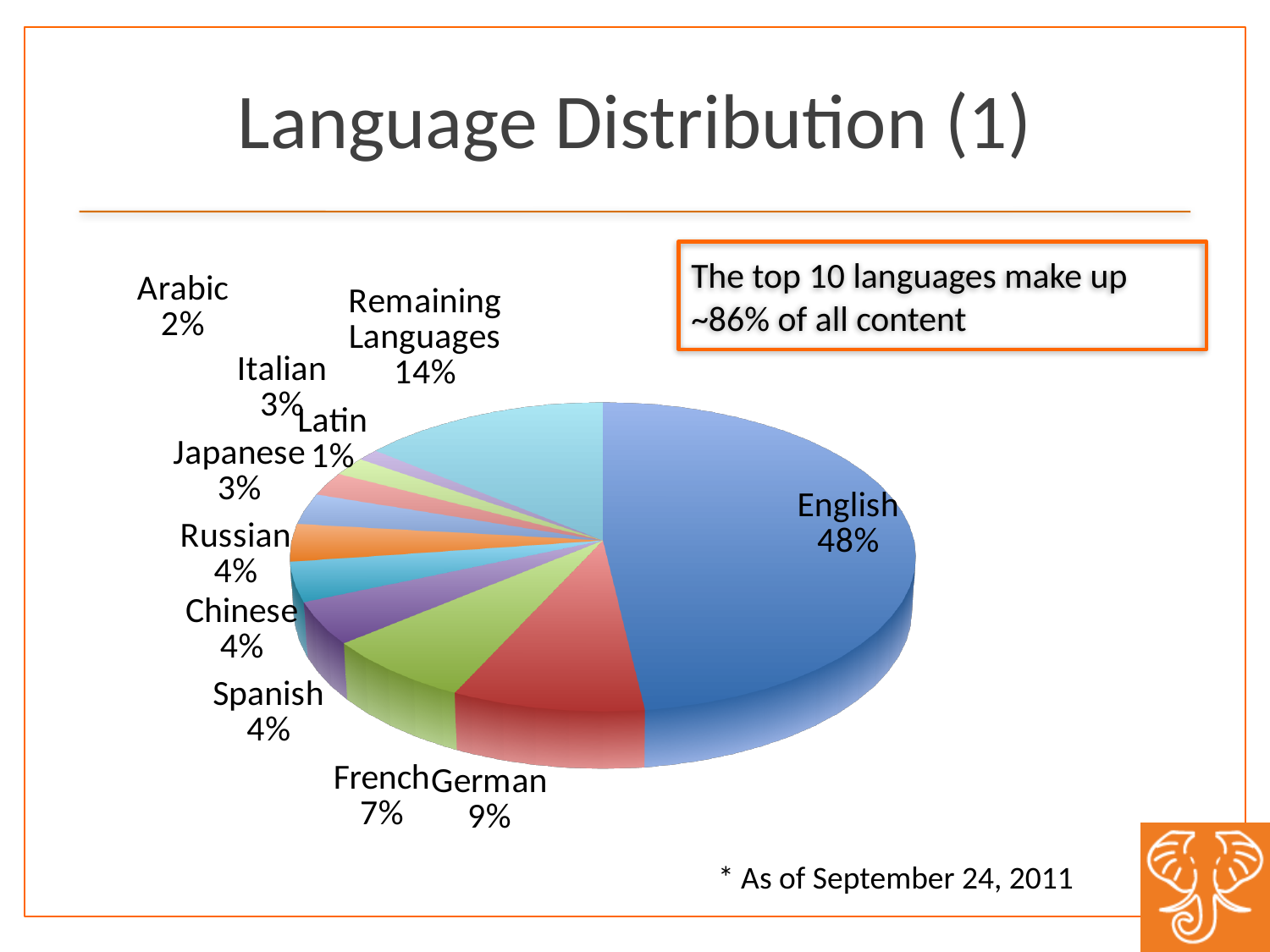
What is the title of the slide containing the chart? Language Distribution (1) What is the combined share of English and German? 57% How many slices does the pie chart have? 11 What share of the pie does English have? 48% What is the difference in percentage points between German and French? 2 Which is larger, the share for Japanese or the share for Arabic? Japanese What percentage is shown for Latin? 1% What percentage is shown for German? 9% What type of chart is shown on the slide? Pie chart Which language has the largest slice of the pie? English What percentage is shown for Remaining Languages? 14% Which labelled slice has the smallest share? Latin